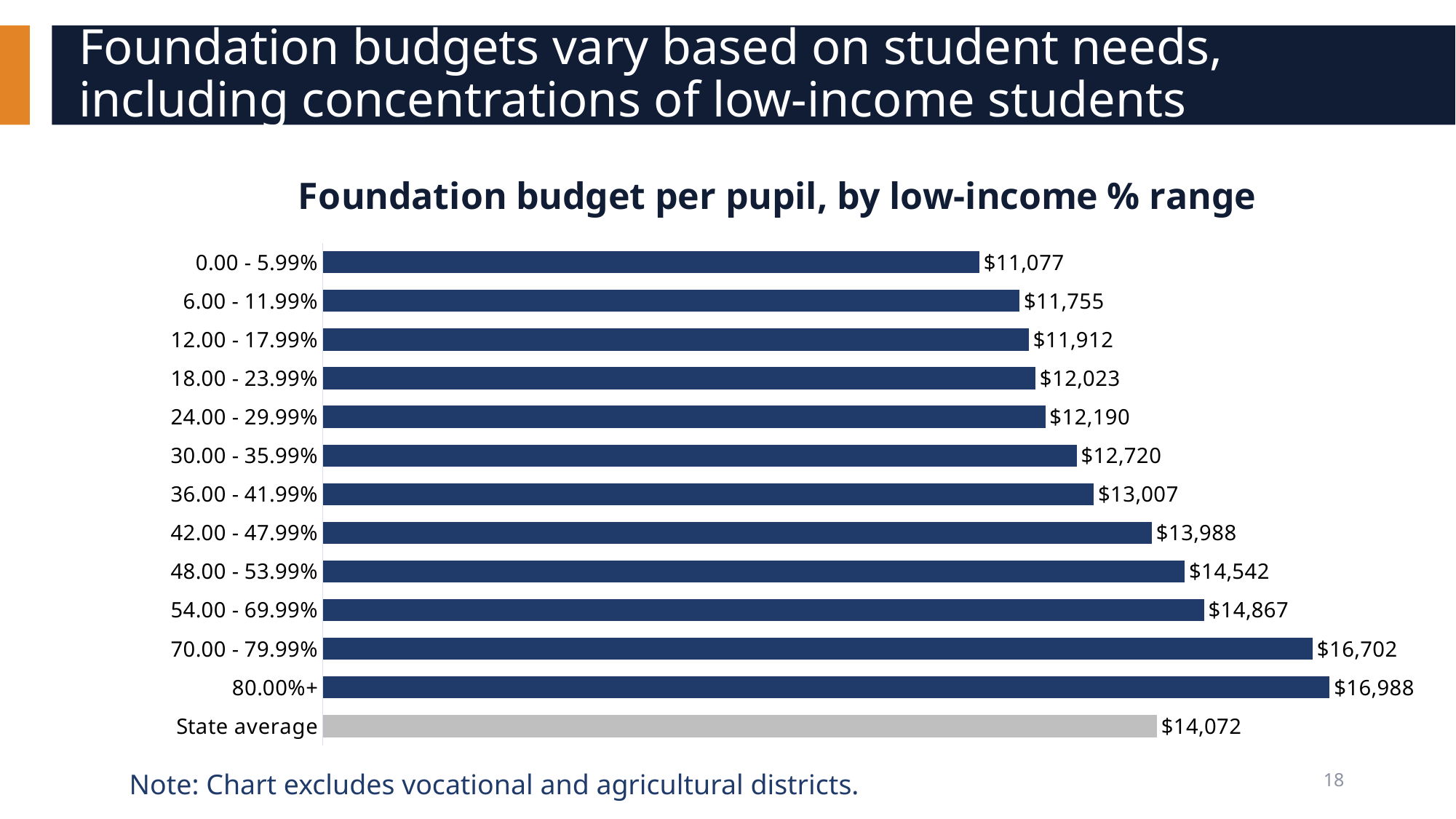
Which low-income % range has the highest foundation budget per pupil? 80.00%+ What is the difference between the foundation budget per pupil for 80.00%+ and for 0.00 - 5.99%? $5,911 What is the difference between the foundation budget per pupil for 70.00 - 79.99% and the State average? $2,630 Which is larger, the foundation budget per pupil for 48.00 - 53.99% or for 36.00 - 41.99%? 48.00 - 53.99% Which low-income % range has the lowest foundation budget per pupil? 0.00 - 5.99% How many bars are shown in the chart? 13 What is the foundation budget per pupil for the State average? $14,072 What is the foundation budget per pupil for the 42.00 - 47.99% low-income range? $13,988 What kind of chart is shown on the slide? Bar chart What is the title of the chart? Foundation budget per pupil, by low-income % range Do the foundation budget values generally rise or fall as the low-income % range increases? Rise What is the foundation budget per pupil for the 0.00 - 5.99% low-income range? $11,077